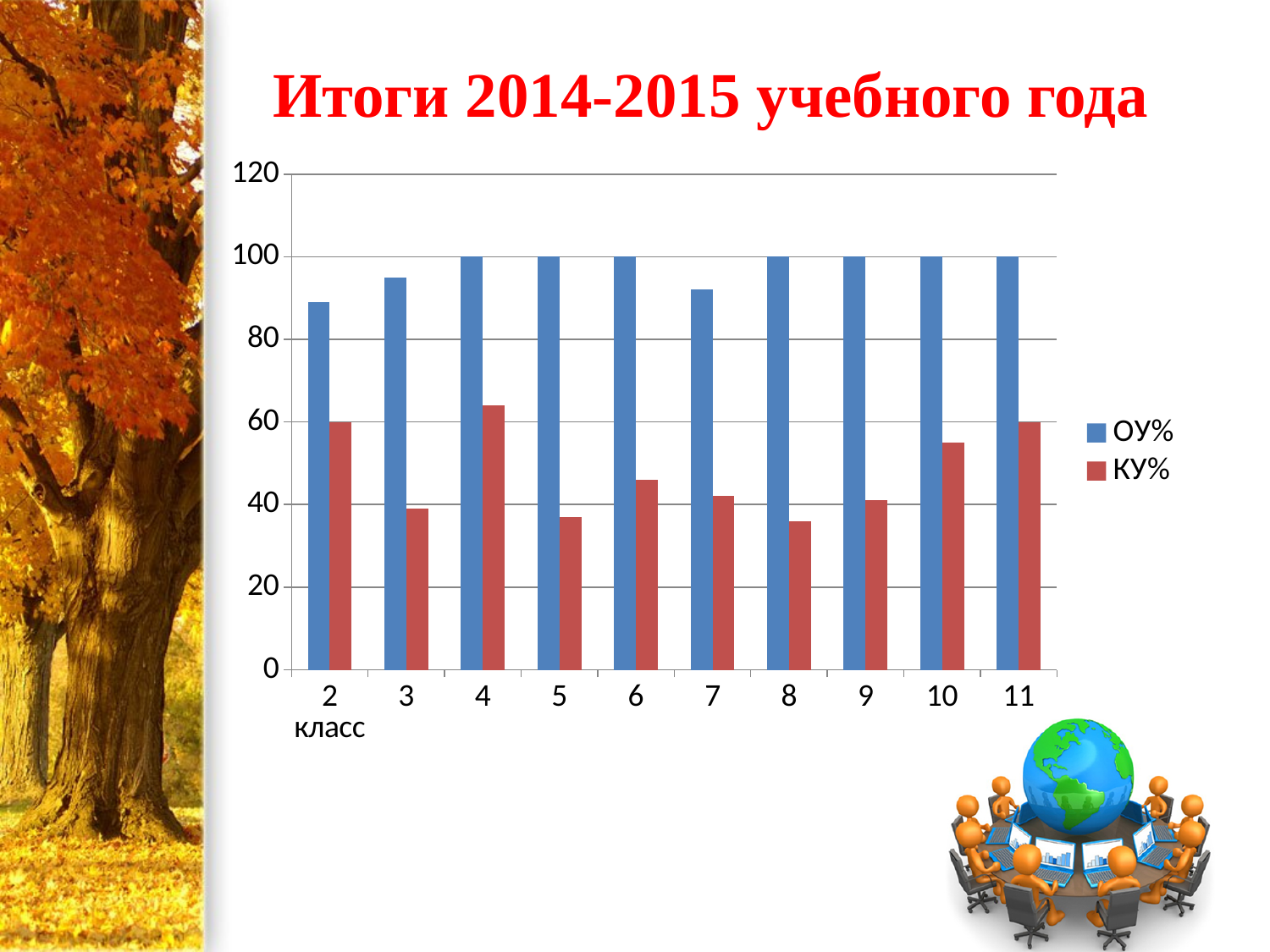
What is the КУ% value for class 11? 60 Is the ОУ% value for class 2 greater or less than 100? less What is the title of the slide above the chart? Итоги 2014-2015 учебного года What is the ОУ% value for class 4? 100 Is the КУ% value for class 8 greater or less than 40? less Which class has the highest КУ% value? 4 What kind of chart is shown on the slide? bar chart Which is larger: the КУ% value for class 3 or for class 4? class 4 For class 2, which is larger: ОУ% or КУ%? ОУ% How many classes (categories) are shown on the x axis? 10 How many series does the legend list? 2 Is the КУ% value for class 4 greater or less than 60? greater